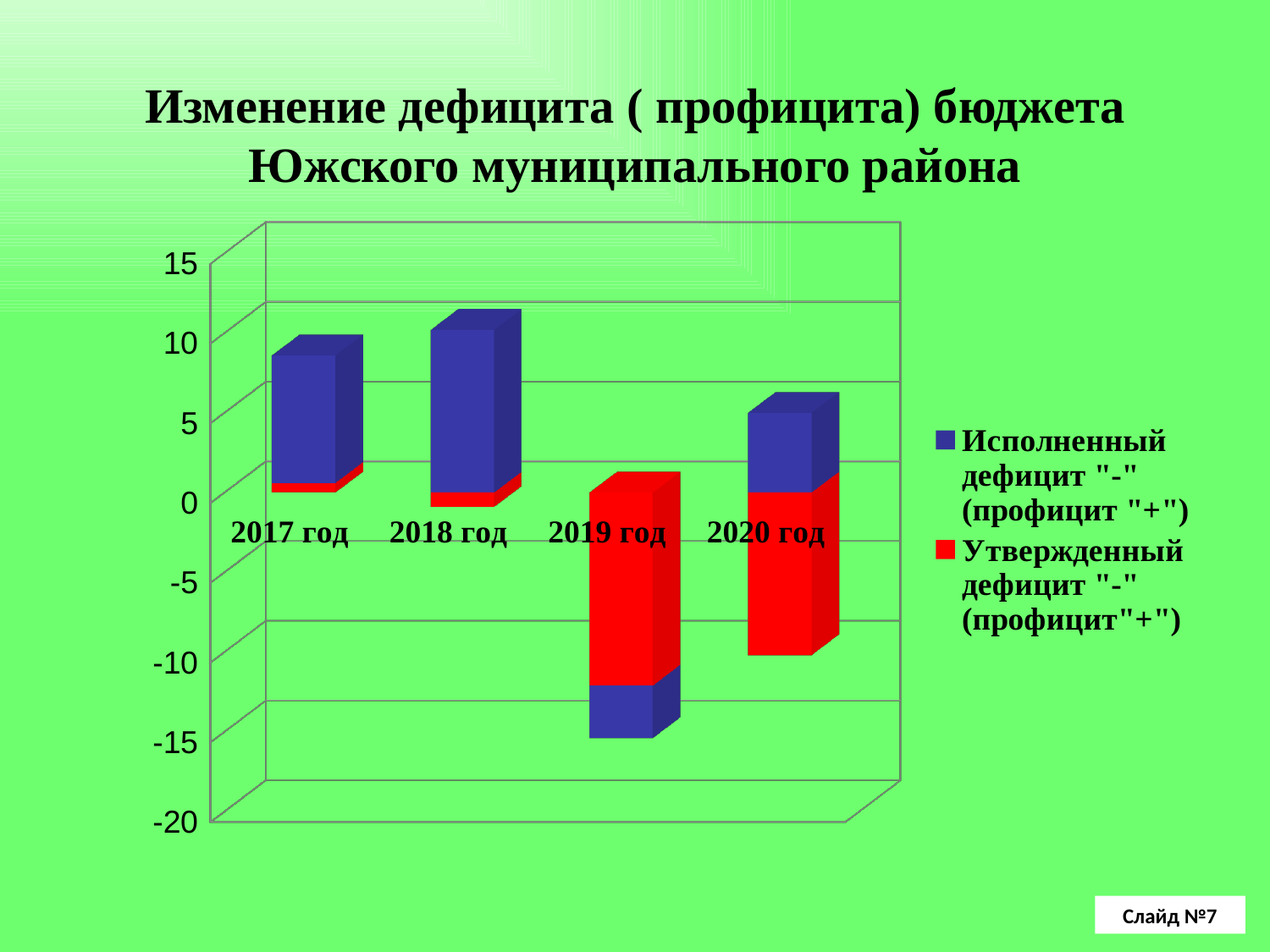
What kind of chart is shown on the slide? bar chart In which year is the value for "Исполненный дефицит "-" (профицит "+")" the lowest? 2019 год In which year is the value for "Утвержденный дефицит "-" (профицит"+")" the lowest? 2019 год How many years are shown on the x axis of the chart? 4 Is the value for "Утвержденный дефицит "-" (профицит"+")" in 2019 год greater or less than -10? less Is the value for "Утвержденный дефицит "-" (профицит"+")" in 2020 год greater or less than 0? less Which colour represents the series "Утвержденный дефицит "-" (профицит"+")"? red In which year is the value for "Исполненный дефицит "-" (профицит "+")" the highest? 2018 год How many series does the chart legend list? 2 Is the value for "Исполненный дефицит "-" (профицит "+")" in 2018 год greater or less than 5? greater Which is larger, the value for "Исполненный дефицит "-" (профицит "+")" in 2018 год or in 2020 год? 2018 год What is the title of the chart on the slide? Изменение дефицита ( профицита) бюджета Южского муниципального района